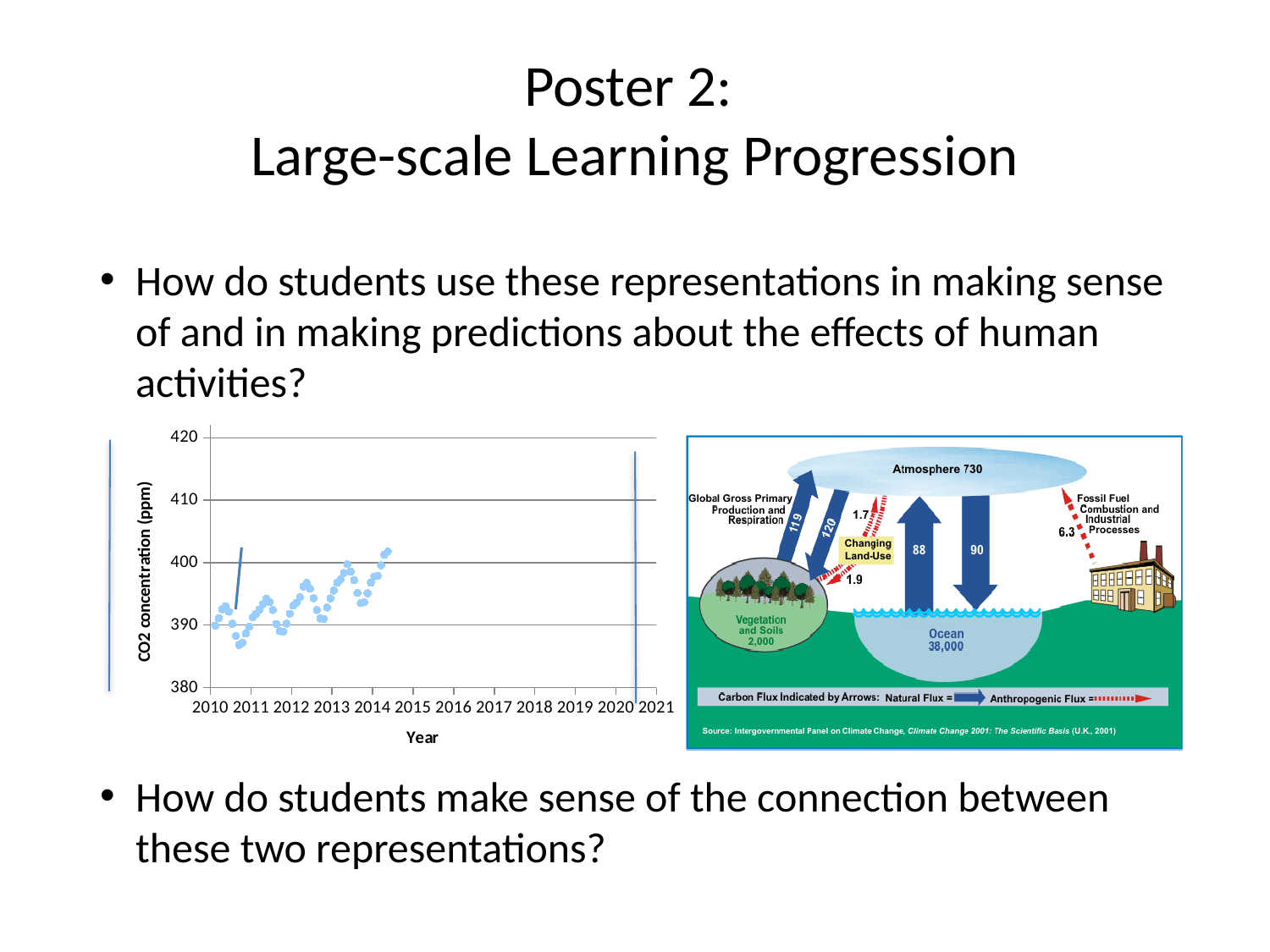
Is any plotted CO2 concentration greater than 410 ppm? No What is the label of the vertical axis of the CO2 chart? CO2 concentration (ppm) Is the CO2 concentration plotted at the start of 2010 greater or less than 400 ppm? Less What is the highest value shown on the vertical axis of the CO2 chart? 420 What is the label of the horizontal axis of the CO2 chart? Year Is the CO2 concentration plotted in early 2014 greater or less than 390 ppm? Greater Do the plotted CO2 data points extend all the way to 2021 on the horizontal axis? No How many year tick labels are shown on the horizontal axis of the CO2 chart? 12 What kind of chart is shown on the left of the slide? Scatter chart Overall, do the plotted CO2 concentration values rise or fall from 2010 to 2014? Rise